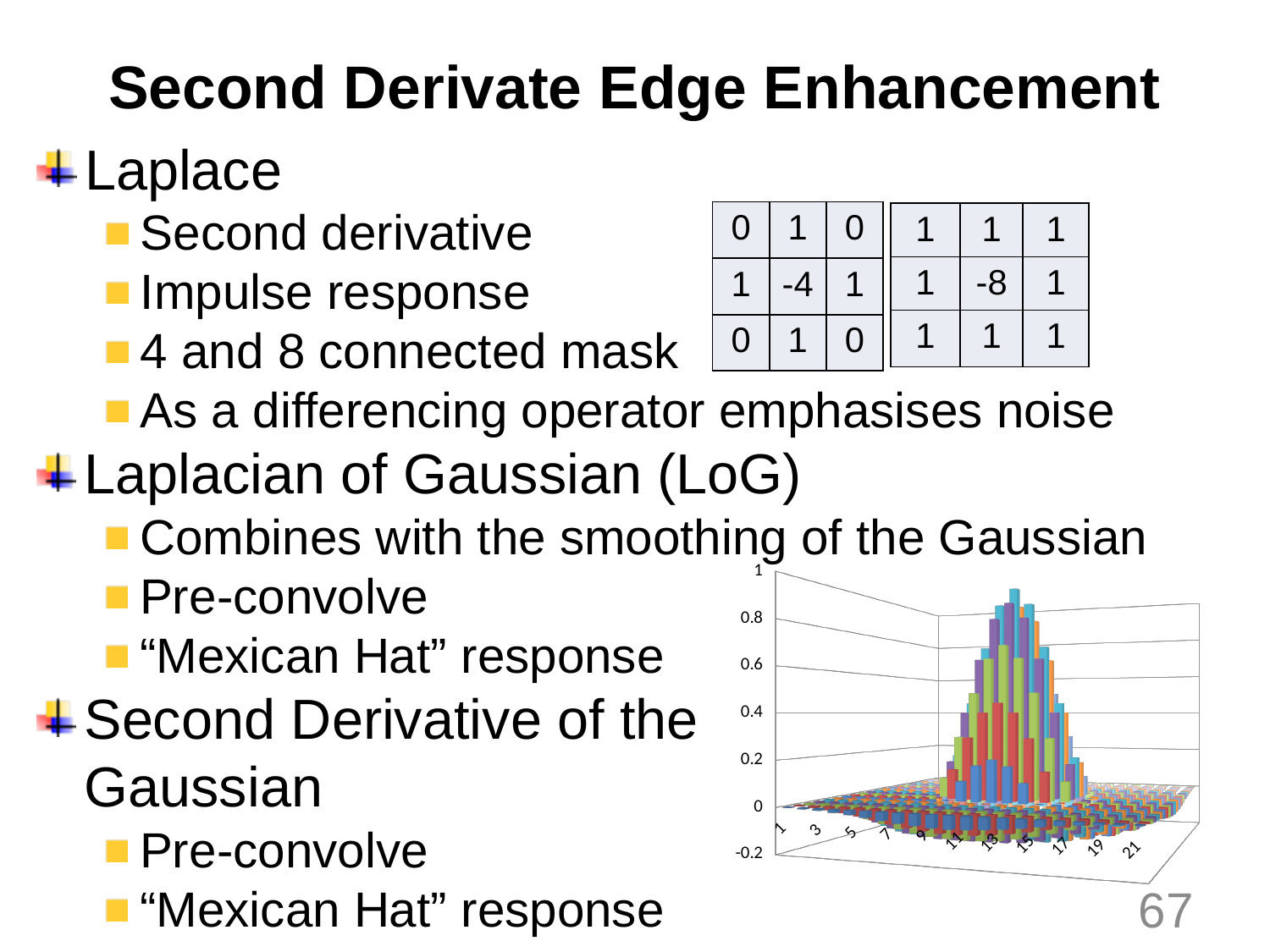
How many category labels are printed along the x axis of the chart? 11 Do the bar heights rise or fall along the x axis from category 1 to category 11? rise Do the bar heights rise or fall along the x axis from category 13 to category 21? fall Is the lowest bar in the chart greater or less than -0.2? greater Is the tallest bar in the chart greater or less than 0.6? greater What is the lowest tick value shown on the vertical axis of the chart? -0.2 What is the highest tick value shown on the vertical axis of the chart? 1 Is the lowest bar in the chart greater or less than 0? less What kind of chart is shown at the bottom right of the slide? bar chart